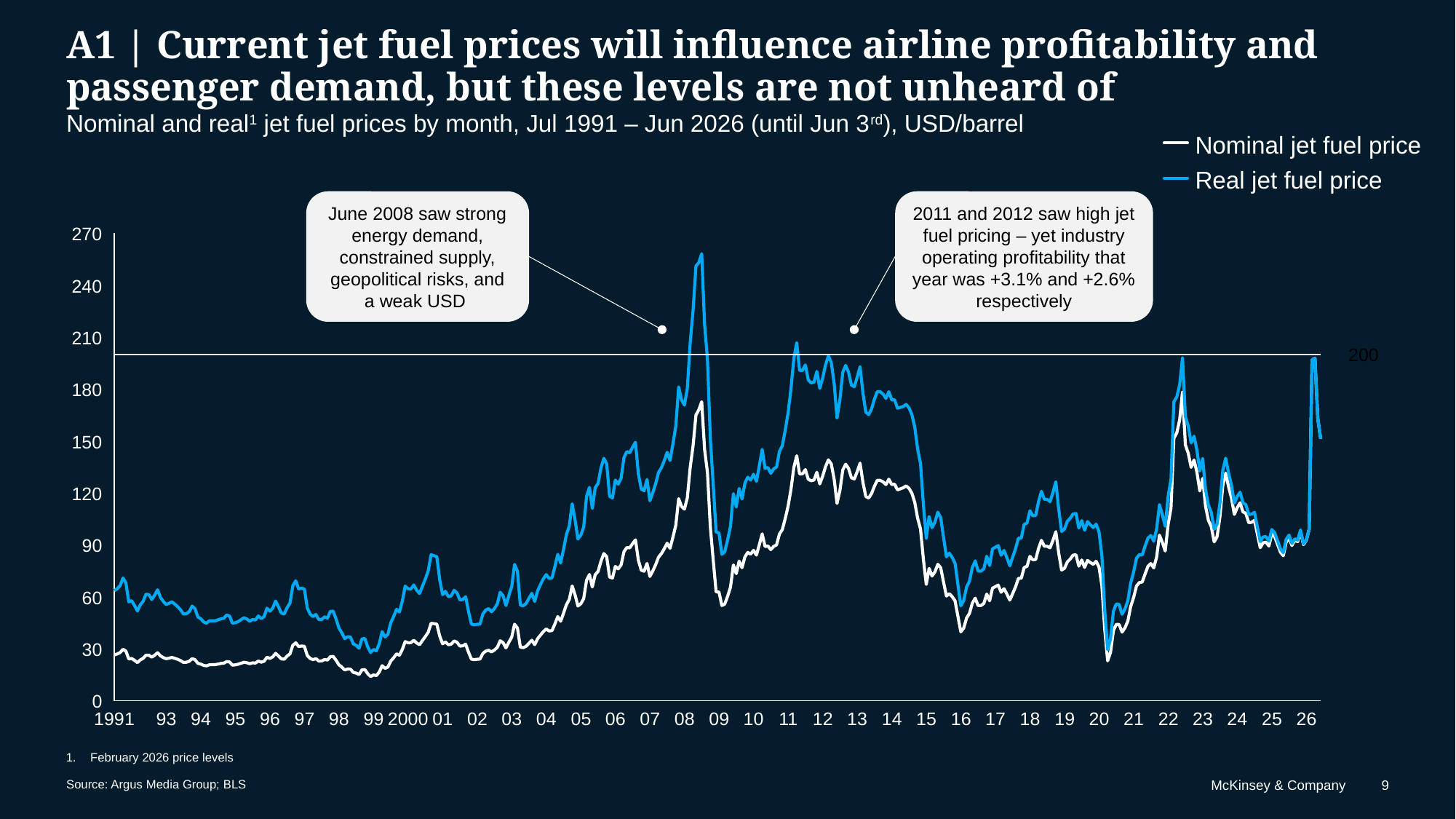
What value is marked by the horizontal reference line across the chart? 200 Is the Nominal jet fuel price in 1998 greater or less than 30? less Does the Nominal jet fuel price rise or fall from 2003 to 2008? Rise Which two series are listed in the legend? Nominal jet fuel price and Real jet fuel price Is the Real jet fuel price in 1998 greater or less than 60? less Is the lowest Nominal jet fuel price in 2020 greater or less than 60? less How many series does the legend list? 2 In 2012, which series is higher, the Nominal jet fuel price or the Real jet fuel price? Real jet fuel price What kind of chart is shown on the slide? Line chart Does the Real jet fuel price rise or fall from 2022 to 2025? Fall